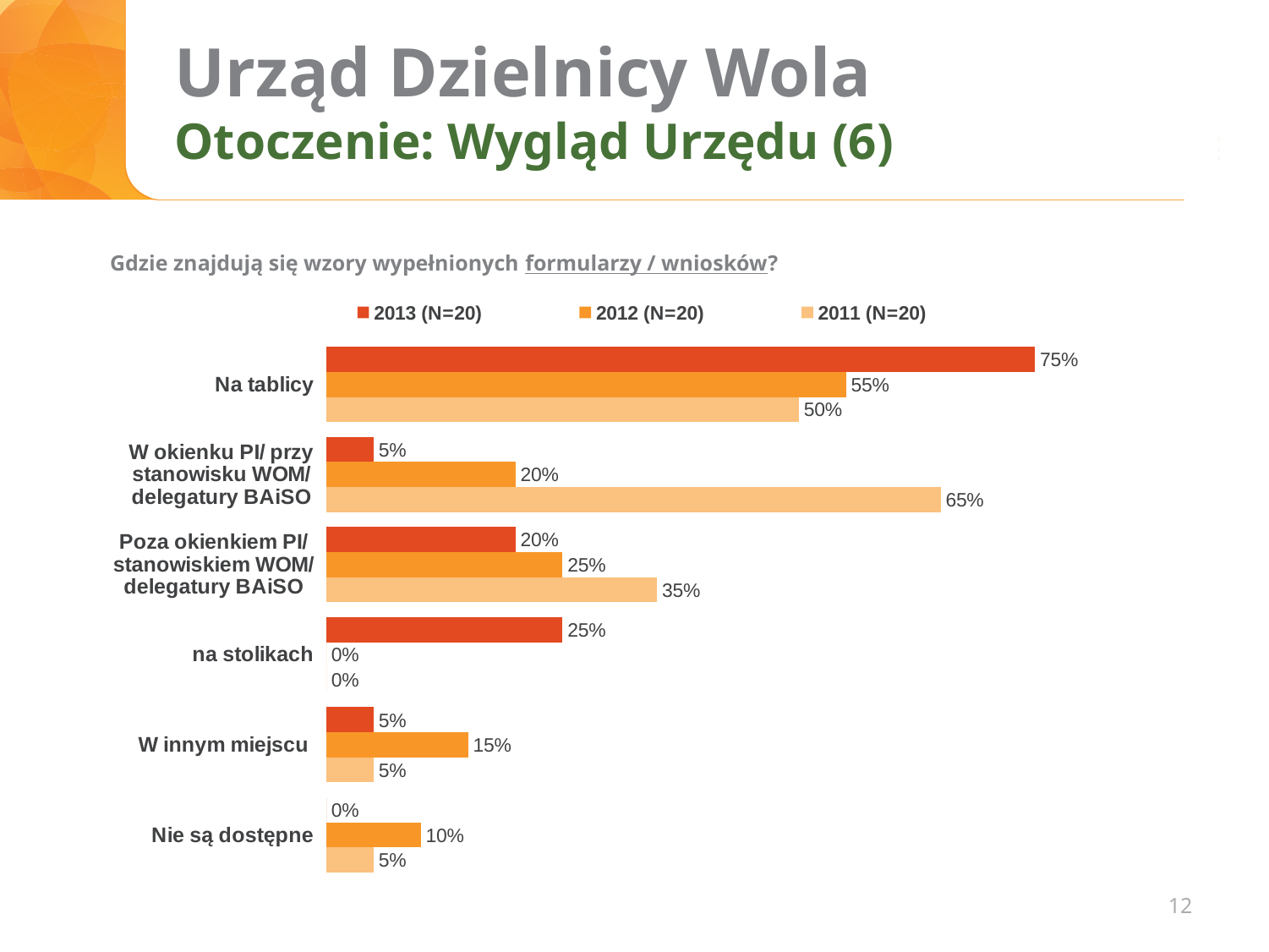
What is the 2012 (N=20) value for "Nie są dostępne"? 10% What is the difference between the 2011 (N=20) and 2013 (N=20) values for "W okienku PI/ przy stanowisku WOM/ delegatury BAiSO"? 60% Which category has the lowest 2012 (N=20) value? na stolikach How many categories are shown on the chart? 6 What is the 2011 (N=20) value for "W okienku PI/ przy stanowisku WOM/ delegatury BAiSO"? 65% How many series does the legend list? 3 What question is the chart about, as stated above it? Gdzie znajdują się wzory wypełnionych formularzy / wniosków? Which category has the highest 2013 (N=20) value? Na tablicy Which is larger for "Poza okienkiem PI/ stanowiskiem WOM/ delegatury BAiSO": the 2012 (N=20) value or the 2011 (N=20) value? 2011 (N=20) What is the 2013 (N=20) value for "Na tablicy"? 75% What is the difference between the 2013 (N=20) and 2011 (N=20) values for "Na tablicy"? 25% What kind of chart is shown on the slide? Bar chart